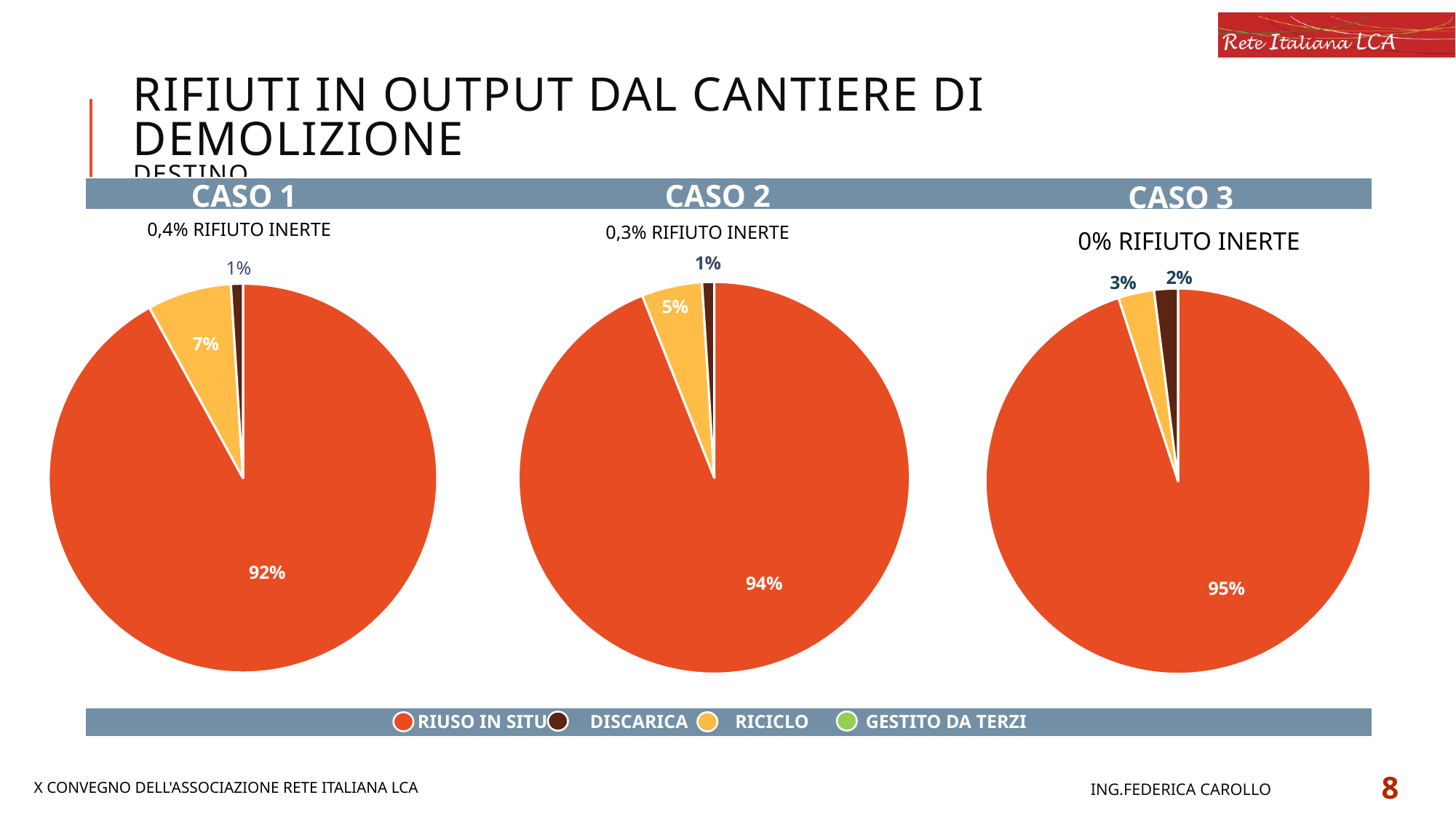
What is the difference between the RIUSO IN SITU share in CASO 3 and in CASO 1? 3% In the CASO 3 pie chart, what share is RICICLO? 3% In the CASO 1 pie chart, which category has the smallest slice? DISCARICA In the CASO 3 pie chart, which category has the largest slice? RIUSO IN SITU In the CASO 3 pie chart, what share is DISCARICA? 2% In the CASO 2 pie chart, what share is RICICLO? 5% What type of chart is used for CASO 1, CASO 2 and CASO 3? Pie chart In the CASO 1 pie chart, what share is RICICLO? 7% How many entries does the shared legend below the pie charts list? 4 In the CASO 2 pie chart, what share is RIUSO IN SITU? 94% In the CASO 1 pie chart, what share is RIUSO IN SITU? 92% Is the RICICLO share larger in CASO 1 or in CASO 2? CASO 1